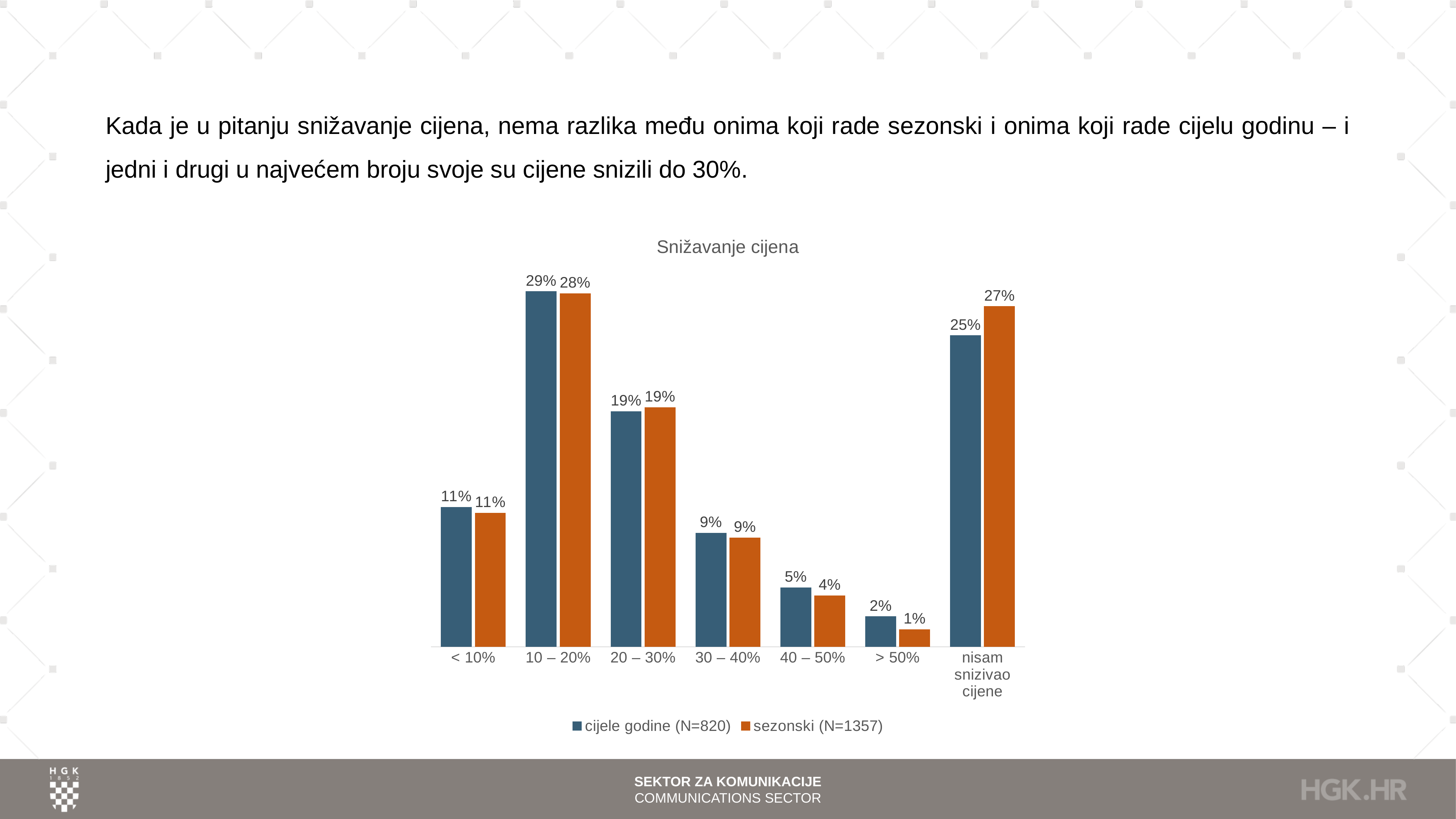
What is the title of the chart? Snižavanje cijena What kind of chart is shown on the slide? bar chart How many series does the legend list? 2 What is the difference between the 'cijele godine (N=820)' values for '10 – 20%' and '20 – 30%'? 10% Which category has the highest value in the 'cijele godine (N=820)' series? 10 – 20% What is the difference between the 'cijele godine (N=820)' and 'sezonski (N=1357)' values for 'nisam snizivao cijene'? 2% What is the value for 'nisam snizivao cijene' in the 'sezonski (N=1357)' series? 27% What is the value for '10 – 20%' in the 'cijele godine (N=820)' series? 29% Which is larger for '40 – 50%': the 'cijele godine (N=820)' value or the 'sezonski (N=1357)' value? cijele godine (N=820) Which category has the lowest value in the 'sezonski (N=1357)' series? > 50% What is the value for '> 50%' in the 'sezonski (N=1357)' series? 1% How many categories are shown on the x axis? 7